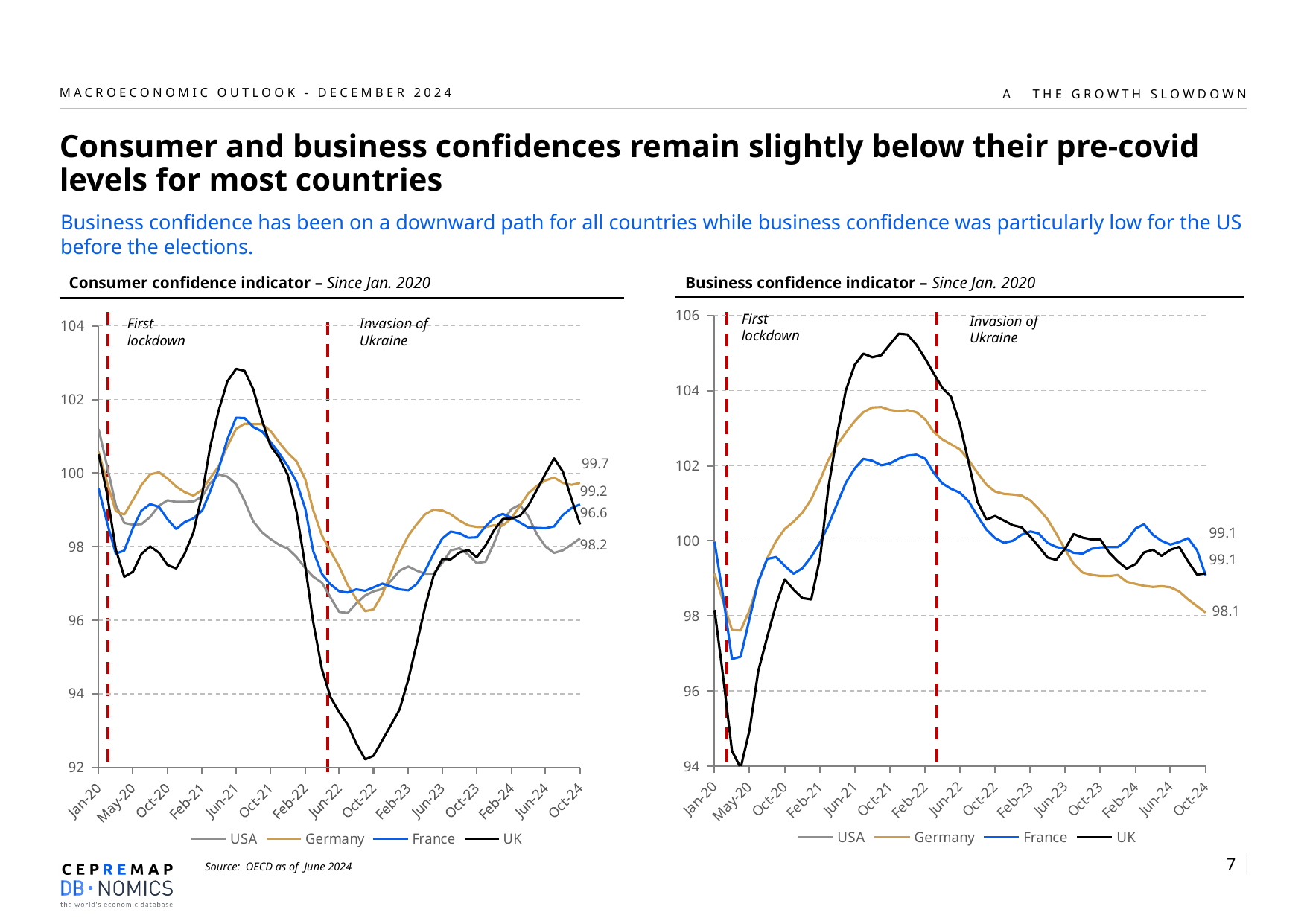
What kind of chart is the Consumer confidence indicator chart? Line chart On the Consumer confidence indicator chart, which series falls to the lowest point? UK What two events are marked by the red dashed vertical lines on the charts? First lockdown and Invasion of Ukraine On the Business confidence indicator chart, what value is labelled for Germany at the end of the series (Oct-24)? 98.1 On the Consumer confidence indicator chart, is the UK value around Oct-22 greater or less than 94? less On the Business confidence indicator chart, at Oct-24 which is higher, France or Germany? France On the Business confidence indicator chart, does the Germany series rise or fall between Jun-22 and Oct-24? Fall On the Business confidence indicator chart, which series reaches the highest peak? UK How many series does the legend of the Business confidence indicator chart list? 4 How many tick labels are shown on the x axis of the Consumer confidence indicator chart? 15 On the Business confidence indicator chart, is the UK peak around Oct-21 greater or less than 104? greater On the Business confidence indicator chart, what is the difference between the France end value (99.1) and the Germany end value (98.1)? 1.0